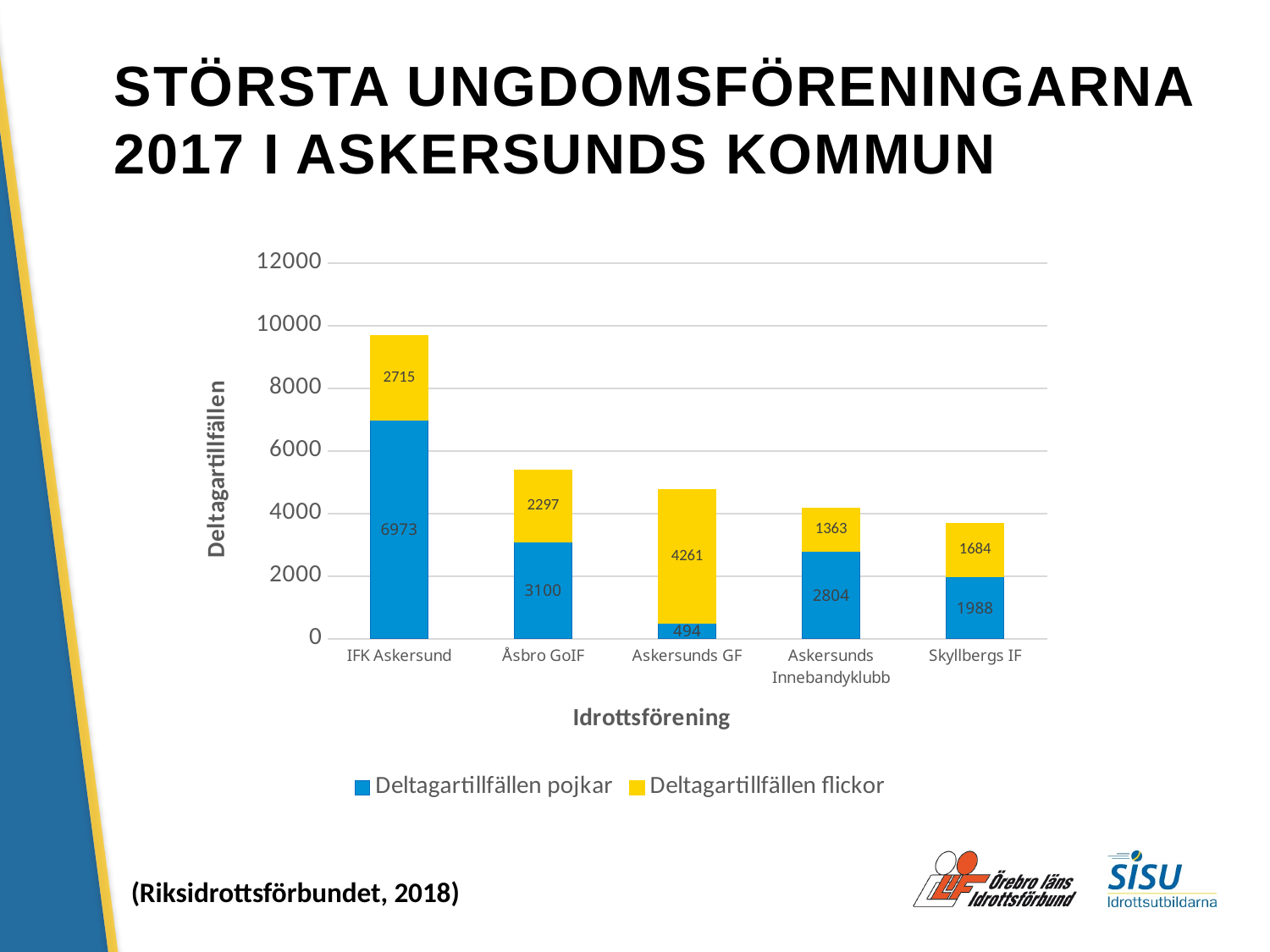
What is the total of the stacked bar for Askersunds Innebandyklubb? 4167 How many Idrottsförening categories are shown on the x axis? 5 How many series does the legend list? 2 What is the value of Deltagartillfällen pojkar for Skyllbergs IF? 1988 What is the total of the stacked bar for IFK Askersund? 9688 What is the value of Deltagartillfällen pojkar for IFK Askersund? 6973 Which Idrottsförening has the lowest value for Deltagartillfällen flickor? Askersunds Innebandyklubb Which is larger for Askersunds GF: Deltagartillfällen pojkar or Deltagartillfällen flickor? Deltagartillfällen flickor What is the value of Deltagartillfällen flickor for Askersunds GF? 4261 Which Idrottsförening has the highest value for Deltagartillfällen pojkar? IFK Askersund What kind of chart is shown on the slide? Stacked bar chart What is the difference between Deltagartillfällen pojkar and Deltagartillfällen flickor for Åsbro GoIF? 803